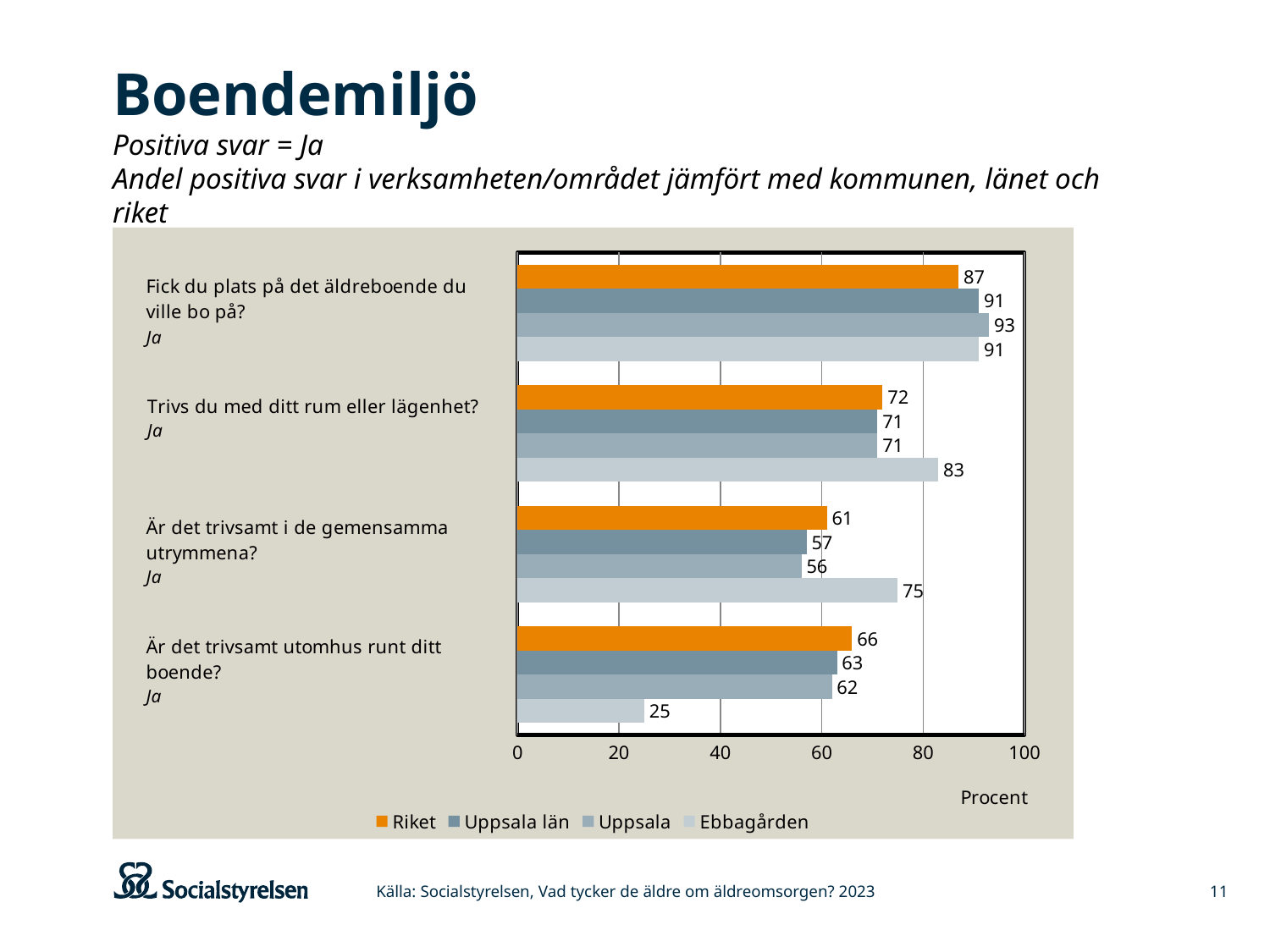
How many series does the legend list? 4 What is the value for Uppsala län on "Är det trivsamt utomhus runt ditt boende?"? 63 What is the value for Ebbagården on "Trivs du med ditt rum eller lägenhet?"? 83 How many questions (categories) are shown on the chart? 4 Which series has the highest value on "Fick du plats på det äldreboende du ville bo på?"? Uppsala What is the value for Riket on "Fick du plats på det äldreboende du ville bo på?"? 87 What is the difference between Ebbagården and Riket on "Är det trivsamt i de gemensamma utrymmena?"? 14 What is the unit label shown below the x axis? Procent What kind of chart is shown on the slide? Bar chart Which series is shown in orange in the legend? Riket Which series has the lowest value on "Är det trivsamt utomhus runt ditt boende?"? Ebbagården Which is larger on "Är det trivsamt utomhus runt ditt boende?": Riket or Ebbagården? Riket